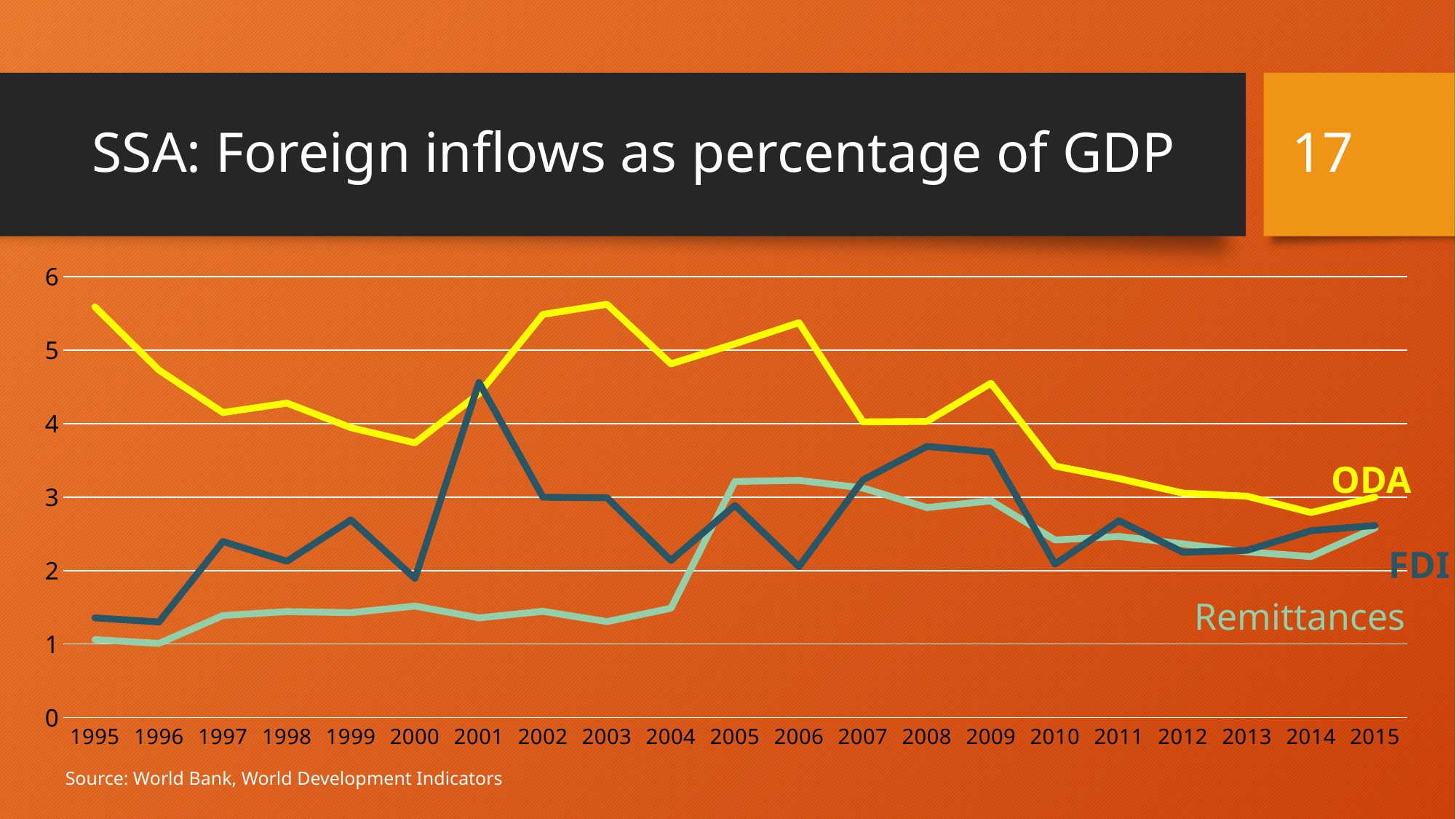
Is the value for ODA in 1995 greater or less than 5? greater How many series are plotted on the chart? 3 What is the title of the chart? SSA: Foreign inflows as percentage of GDP What kind of chart is shown on the slide? line chart In 2005, which is larger: Remittances or FDI? Remittances Which series has the lowest value in 1995? Remittances How many years are plotted along the x axis? 21 Is the value for Remittances in 1996 greater or less than 2? less Does ODA rise or fall from 1995 to 2000? fall In which year does FDI reach its highest value? 2001 Is the value for FDI in 2001 greater or less than 4? greater